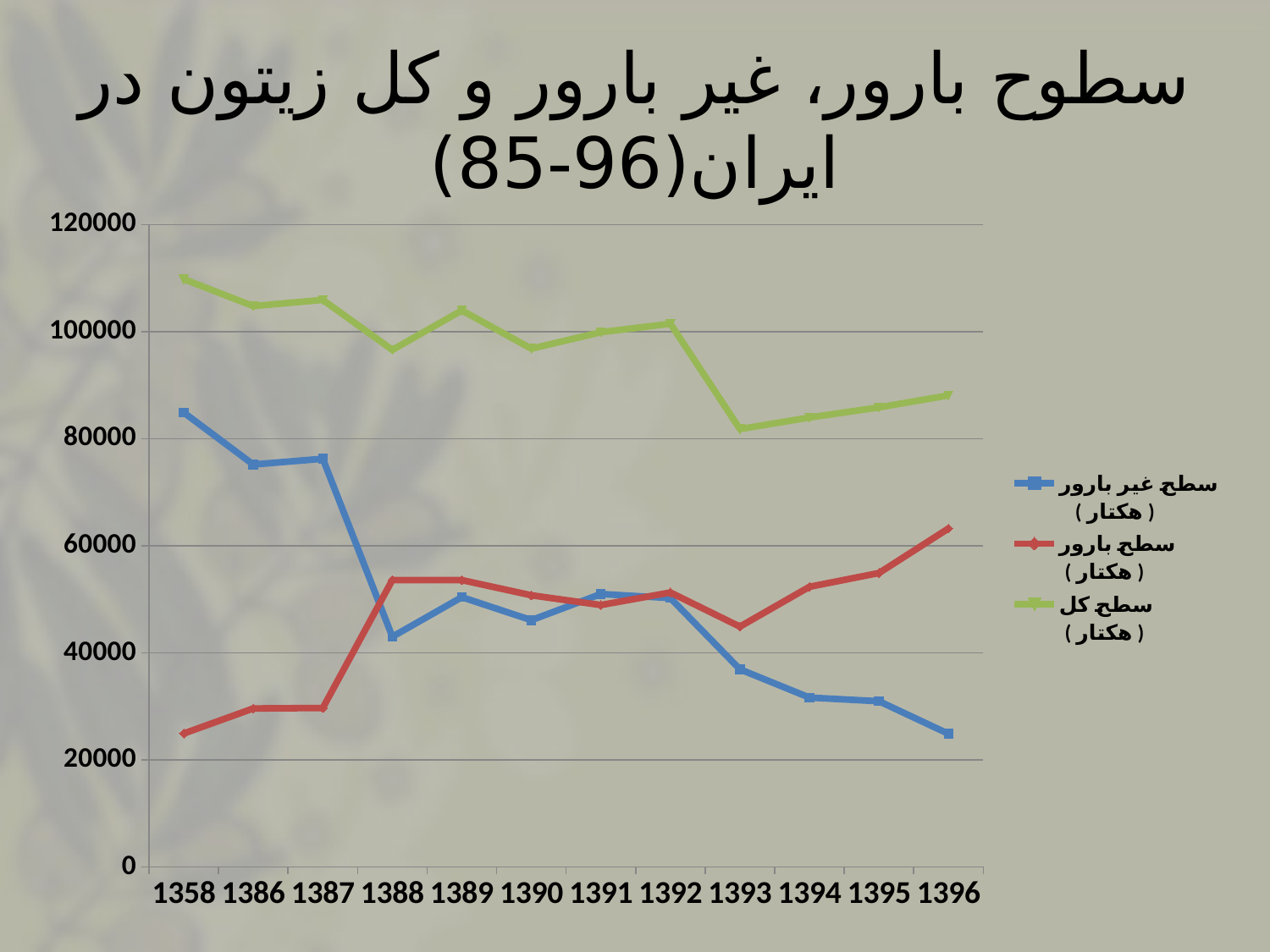
Is the value of سطح کل (هکتار) in 1358 greater or less than 100000? greater In 1358, which is larger: سطح غیر بارور (هکتار) or سطح بارور (هکتار)? سطح غیر بارور (هکتار) In which year is سطح غیر بارور (هکتار) lowest? 1396 What kind of chart is shown on the slide? line chart Is the value of سطح بارور (هکتار) in 1387 greater or less than 40000? less In which year is سطح کل (هکتار) highest? 1358 Does the سطح غیر بارور (هکتار) series overall rise or fall from 1358 to 1396? fall How many series does the legend list? 3 Is the value of سطح غیر بارور (هکتار) in 1396 greater or less than 40000? less Does the سطح بارور (هکتار) series overall rise or fall from 1358 to 1396? rise How many years are shown along the x axis? 12 Which series is drawn in green? سطح کل (هکتار)